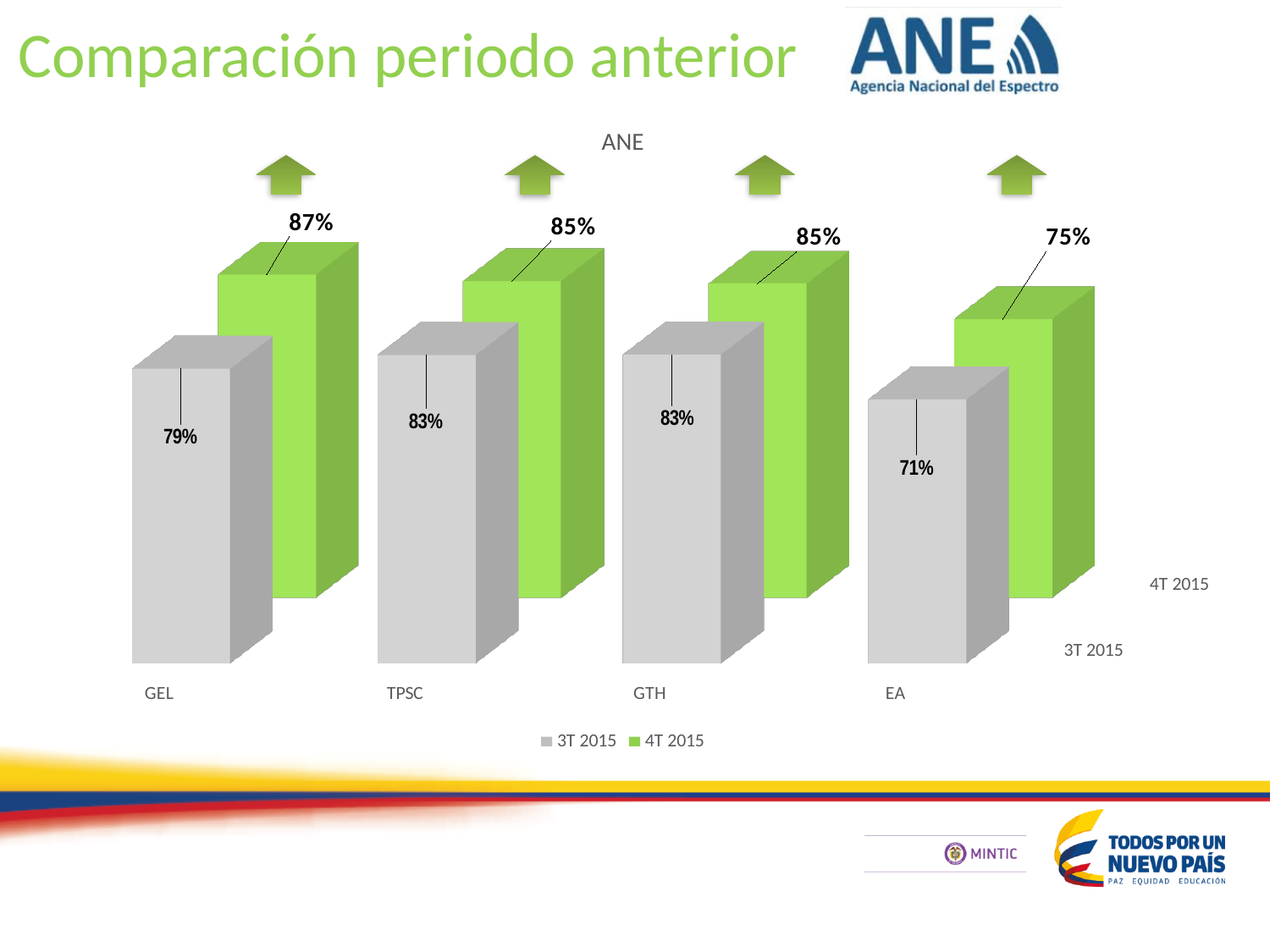
What is the difference between the 4T 2015 and 3T 2015 values for EA? 4% Which category has the highest value in 4T 2015? GEL What is the value for TPSC in 3T 2015? 83% How many series does the legend list? 2 What is the value for GEL in 4T 2015? 87% What is the value for GTH in 4T 2015? 85% Which category has the lowest value in 3T 2015? EA Which is larger, the 4T 2015 value for TPSC or the 4T 2015 value for EA? TPSC What is the value for EA in 3T 2015? 71% How many categories are shown on the x axis? 4 What kind of chart is shown on the slide? Bar chart What is the difference between the 4T 2015 and 3T 2015 values for GEL? 8%